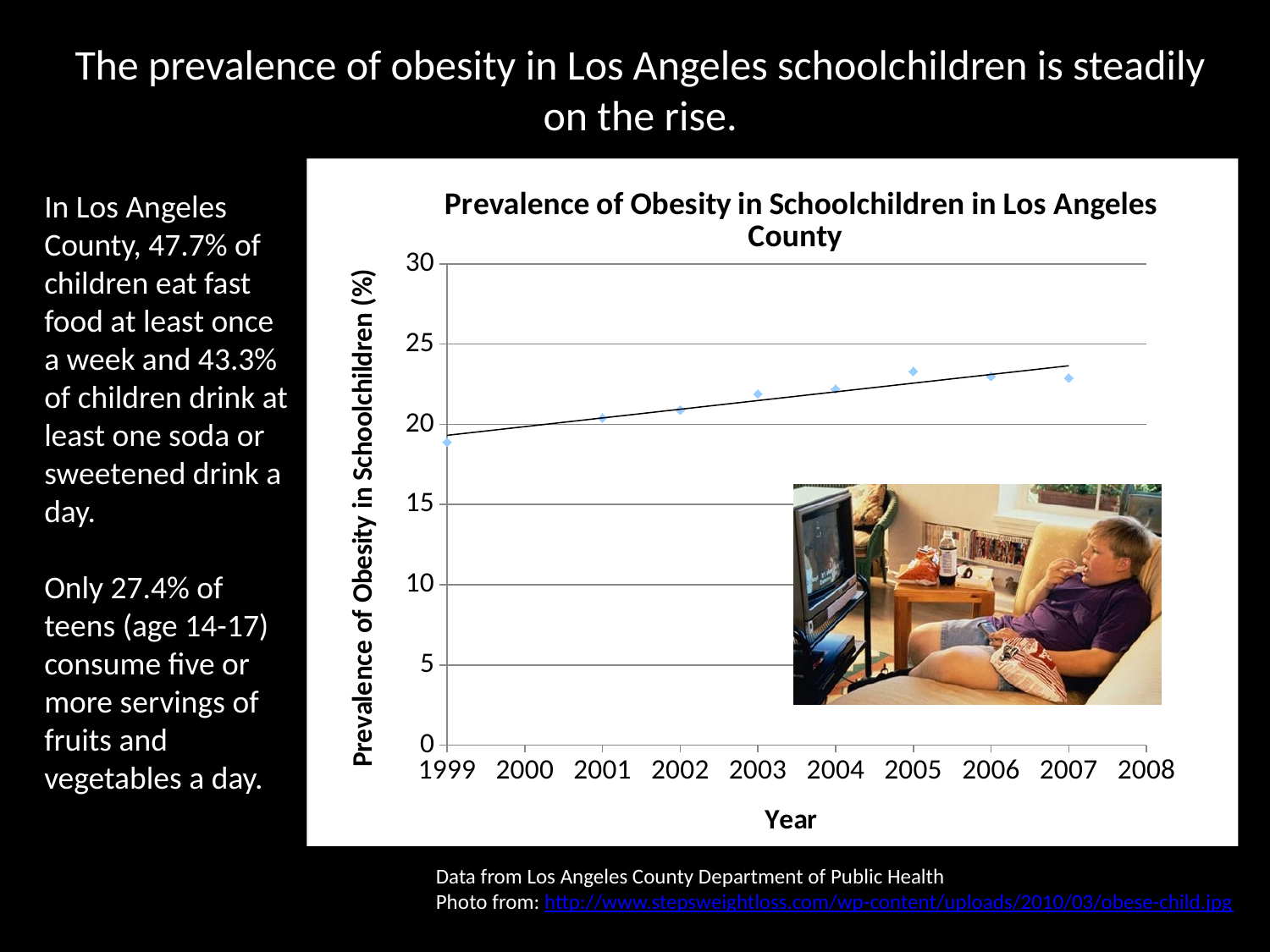
What is the title of the chart? Prevalence of Obesity in Schoolchildren in Los Angeles County Which year has the lowest prevalence of obesity in the chart? 1999 Is the value for 2007 greater or less than 20? greater How many data points are plotted in the chart? 8 Which is larger, the value for 1999 or the value for 2005? 2005 Is the value for 2005 greater or less than 20? greater Which is larger, the value for 2001 or the value for 2004? 2004 What kind of chart is shown on the slide? scatter chart Is the value for 1999 greater or less than 20? less What is the label of the vertical axis of the chart? Prevalence of Obesity in Schoolchildren (%) Do the plotted values generally rise or fall from 1999 to 2007? rise